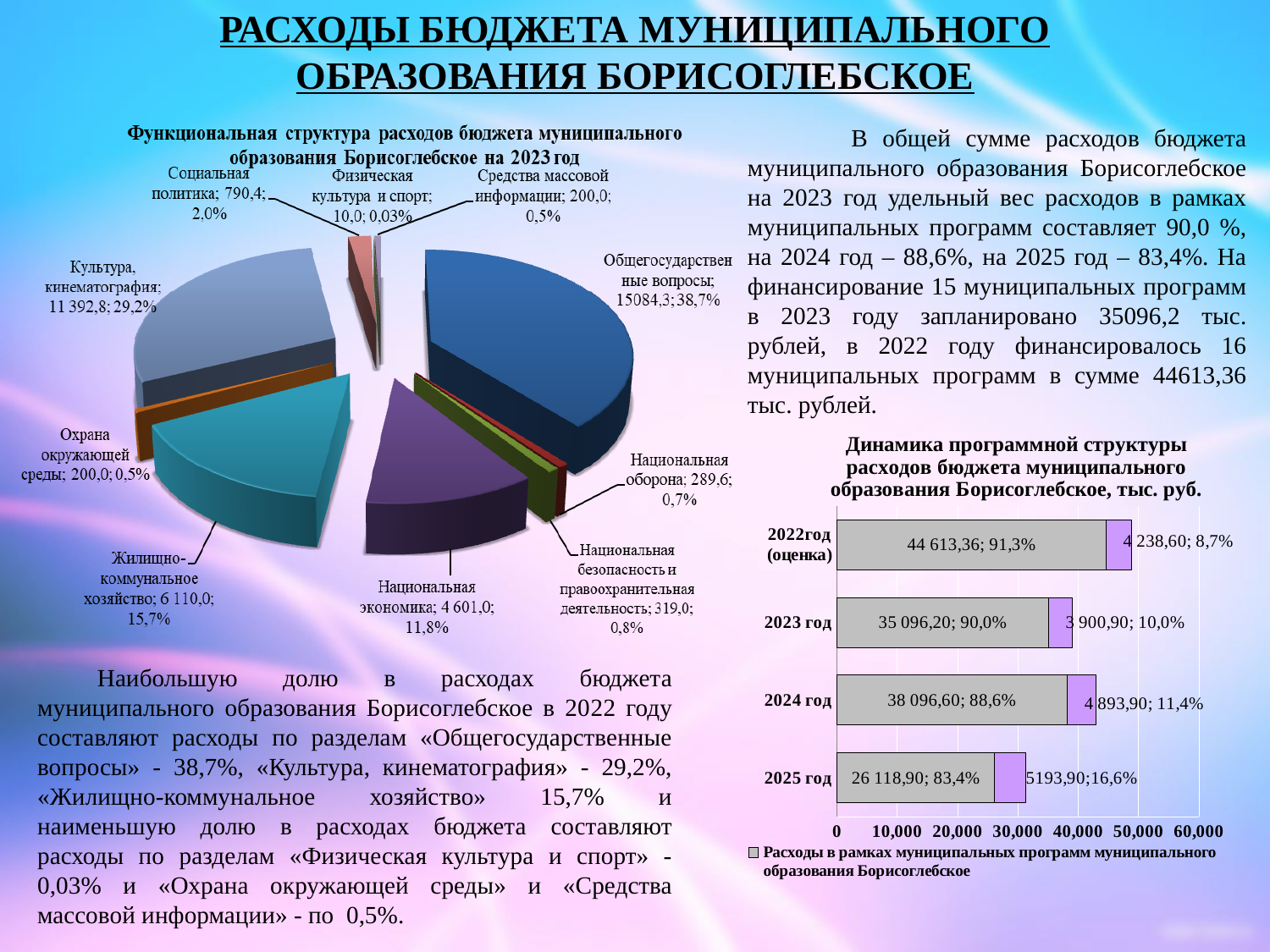
In the pie chart on the left, what is the difference in percentage points between 'Общегосударственные вопросы' and 'Культура, кинематография'? 9,5 In the pie chart on the left, what value is shown for 'Культура, кинематография'? 11 392,8 In the pie chart on the left, which is larger: 'Жилищно-коммунальное хозяйство' or 'Национальная экономика'? Жилищно-коммунальное хозяйство In the pie chart on the left, which category has the smallest share? Физическая культура и спорт In the pie chart on the left, which category has the largest share? Общегосударственные вопросы In the bar chart on the right, which year has the lowest value for 'Расходы в рамках муниципальных программ'? 2025 год What kind of chart is 'Динамика программной структуры расходов бюджета муниципального образования Борисоглебское, тыс. руб.'? Bar chart In the pie chart on the left, how many categories are shown? 10 In the bar chart on the right, what is the value of 'Расходы в рамках муниципальных программ' for 2024 год? 38 096,60 In the pie chart 'Функциональная структура расходов бюджета муниципального образования Борисоглебское на 2023 год', what share is shown for 'Общегосударственные вопросы'? 38,7% In the bar chart on the right, how many years are shown? 4 In the bar chart on the right, what is the total of the stacked bar for 2023 год? 38 997,10